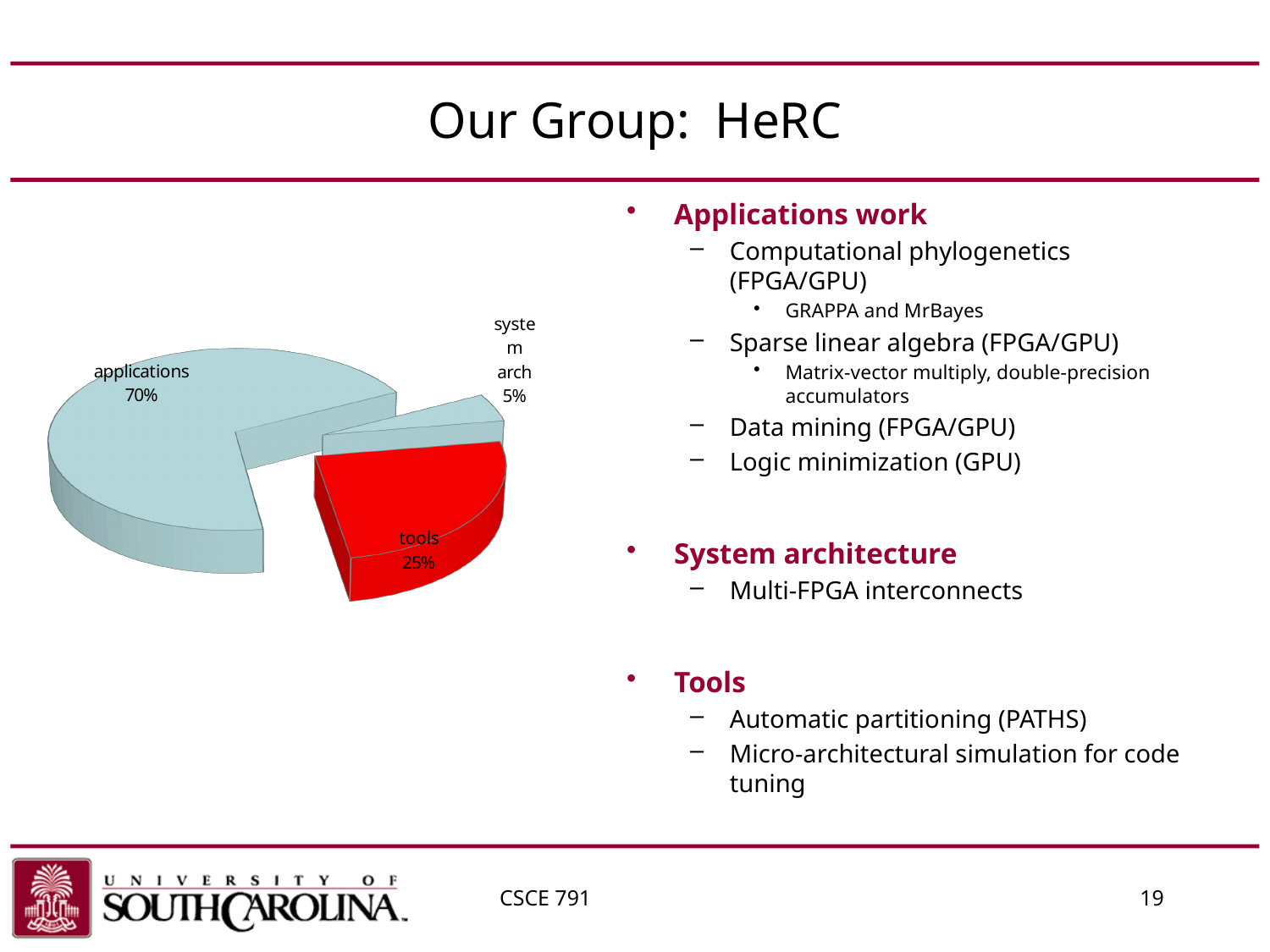
Which is larger, the tools slice or the system arch slice? tools Which slice of the pie is the largest? applications What is the difference in percentage points between the applications slice and the tools slice? 45 What share of the pie does the tools slice represent? 25% What kind of chart is shown on the slide? pie chart How many slices does the pie chart have? 3 What is the combined share of the tools and system arch slices? 30% What share of the pie does the system arch slice represent? 5% What is the difference in percentage points between the tools slice and the system arch slice? 20 Which slice of the pie is the smallest? system arch What colour is the tools slice of the pie chart? red What share of the pie does the applications slice represent? 70%